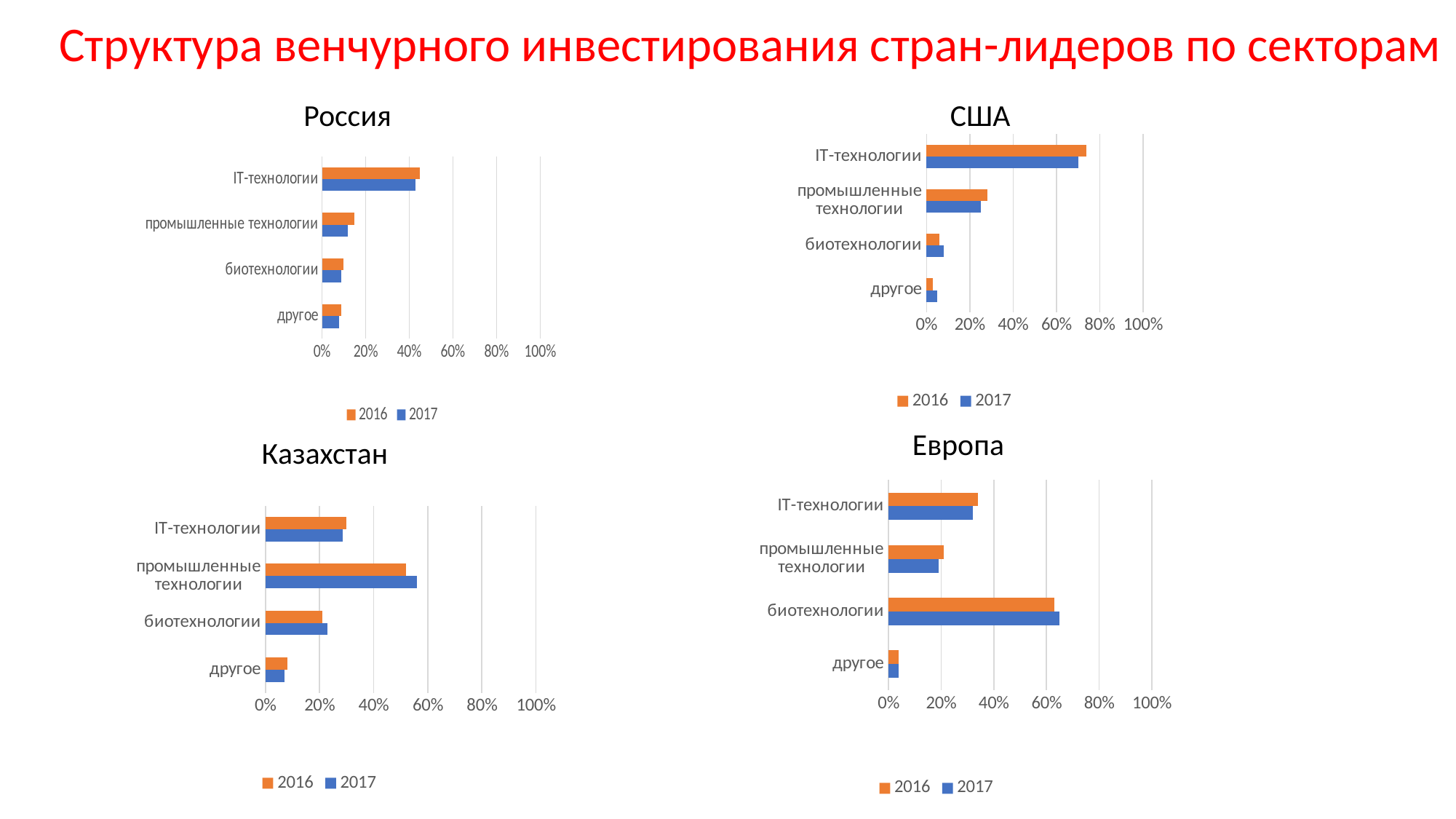
On the США chart, which category has the highest value for 2016? IT-технологии On the Европа chart, which category has the highest value for 2016? биотехнологии On the Казахстан chart, how many categories are shown? 4 On the Казахстан chart, which has the larger 2016 value: промышленные технологии or IT-технологии? промышленные технологии On the Казахстан chart, which category has the highest value for 2017? промышленные технологии On the Россия chart, which category has the lowest value for 2017? другое On the США chart, how many series does the legend list? 2 On the Россия chart, what kind of chart is shown? bar chart On the Россия chart, is the 2016 value for IT-технологии greater or less than 60%? less On the Европа chart, is the 2017 value for биотехнологии greater or less than 40%? greater On the Европа chart, what are the two legend entries? 2016 and 2017 On the США chart, is the 2016 value for IT-технологии greater or less than 60%? greater